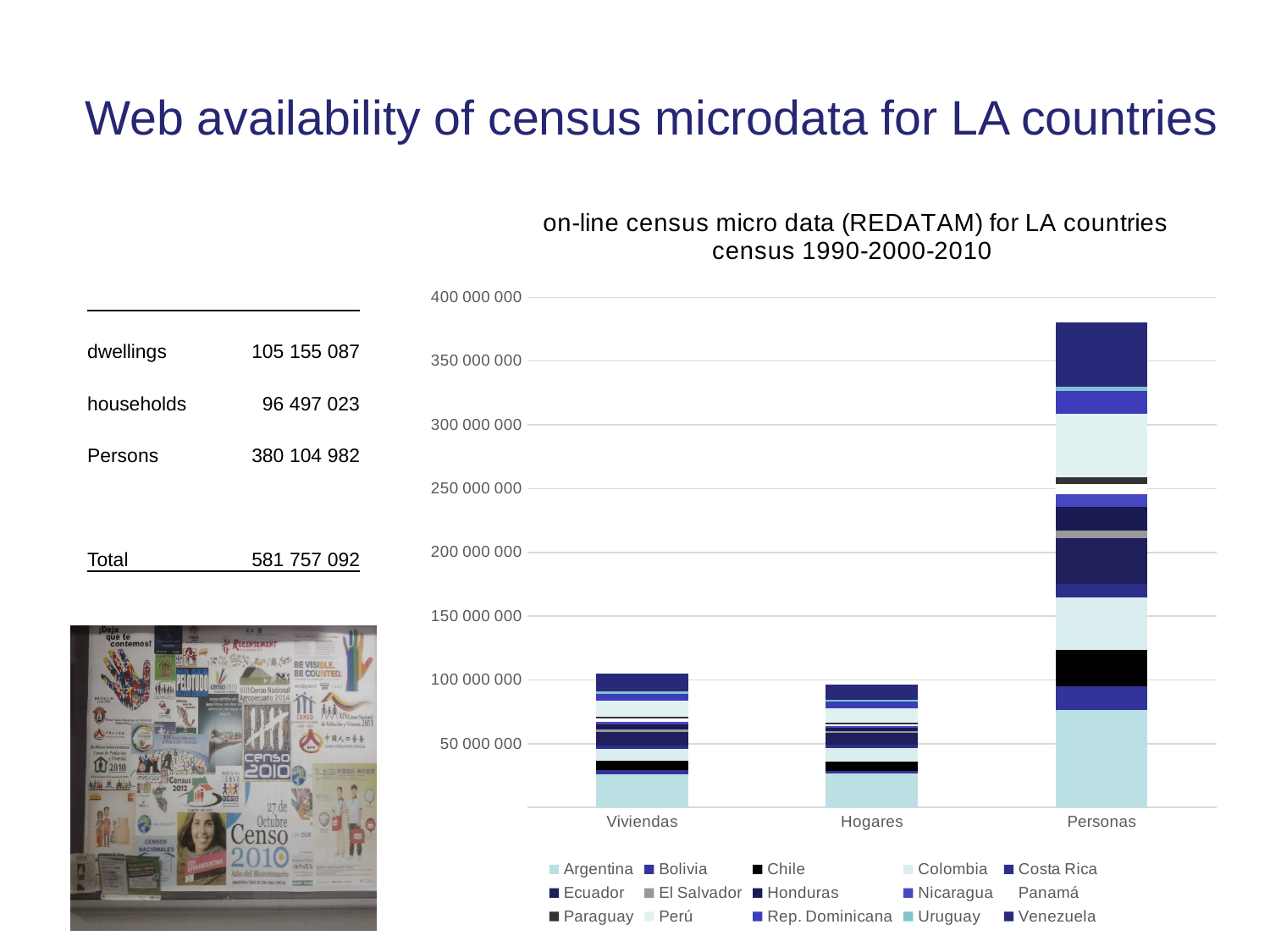
Is the total stacked bar for Viviendas greater or less than 150 000 000? less Which country is listed first in the chart legend? Argentina Which category has the tallest stacked bar? Personas Is the total stacked bar for Personas greater or less than 400 000 000? less Is the total stacked bar for Personas greater or less than 350 000 000? greater Which stacked bar is taller, Viviendas or Hogares? Viviendas How many categories are shown on the x axis of the chart? 3 What is the title of the chart? on-line census micro data (REDATAM) for LA countries census 1990-2000-2010 What type of chart is shown on the slide? stacked bar chart Which category has the shortest stacked bar? Hogares How many series (countries) does the chart legend list? 15